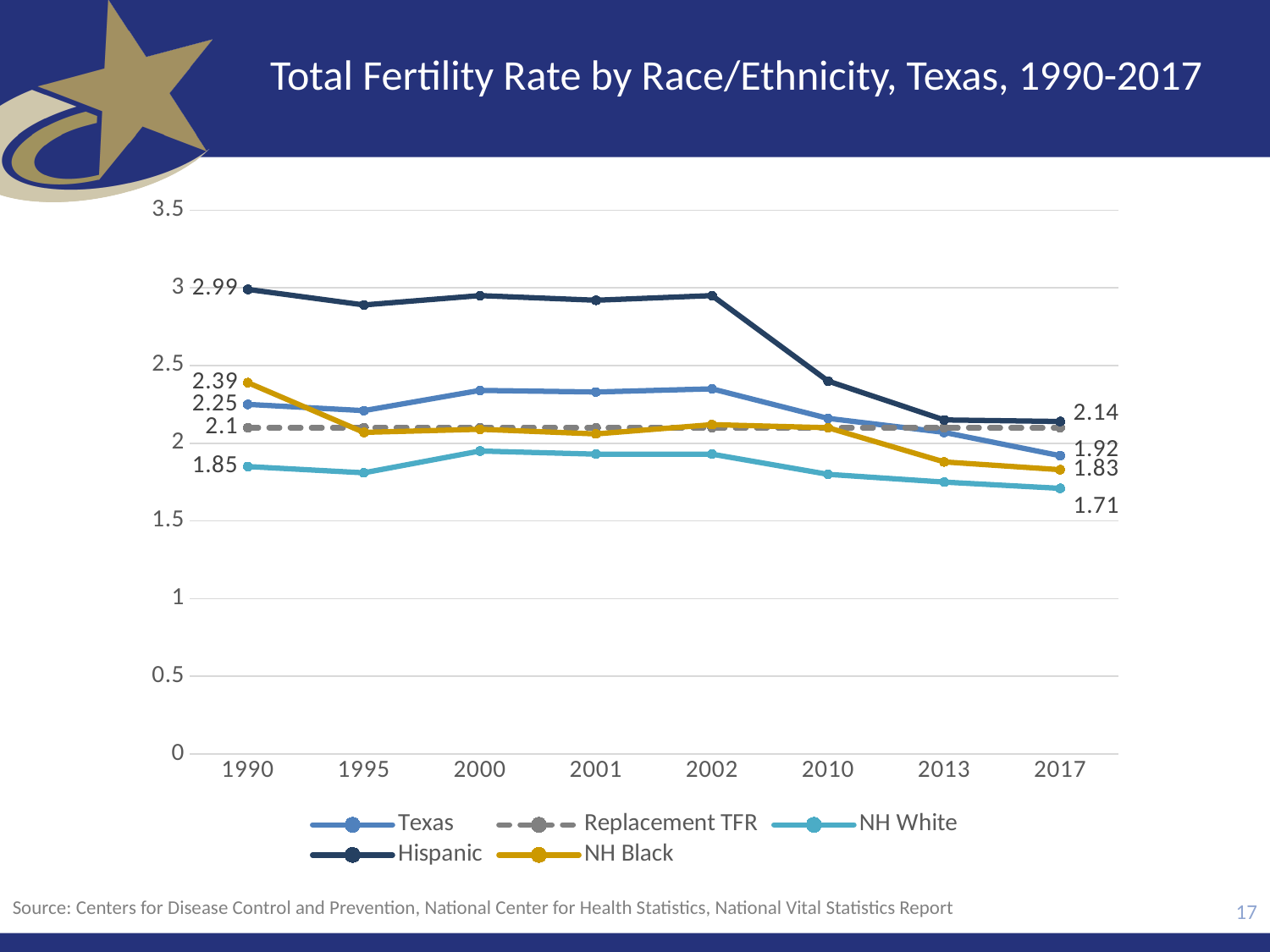
Is the Hispanic value in 2002 greater or less than 2.5? greater What was the NH Black total fertility rate in 1990? 2.39 By how much did the Hispanic total fertility rate fall from 1990 to 2017? 0.85 What kind of chart is shown on the slide? line chart What was the NH White total fertility rate in 2017? 1.71 Which series had the highest total fertility rate in 1990? Hispanic How many years are shown on the x axis? 8 How many series does the legend list? 5 Which series had the lowest total fertility rate in 2017? NH White Does the Hispanic total fertility rate rise or fall from 2002 to 2017? fall What was the Texas total fertility rate in 2017? 1.92 What was the Hispanic total fertility rate in 1990? 2.99